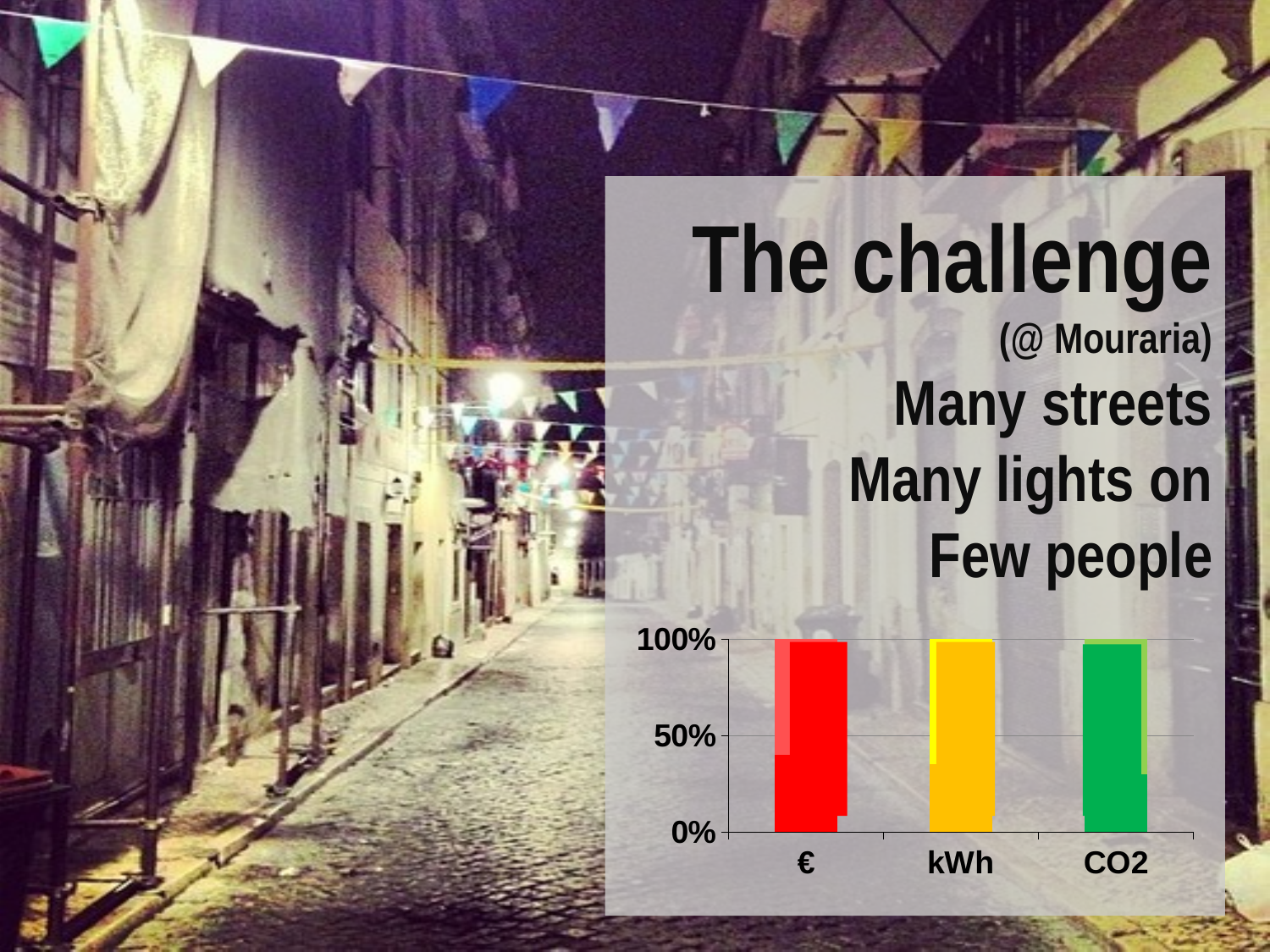
What are the three category labels on the x axis of the chart? €, kWh, CO2 How many categories are shown on the x axis of the chart? 3 Is the value of the shorter bar for CO2 greater or less than 50%? less What kind of chart is shown on the slide? bar chart What colour is the bar for the kWh category? yellow Is the value of the shorter bar for € greater or less than 50%? less What is the highest tick value shown on the y axis of the chart? 100% Is the value of the shorter bar for kWh greater or less than 50%? less Which has the larger shorter bar, € or CO2? € What value does the tallest bar for kWh reach on the y axis? 100% What value does the tallest bar for € reach on the y axis? 100%